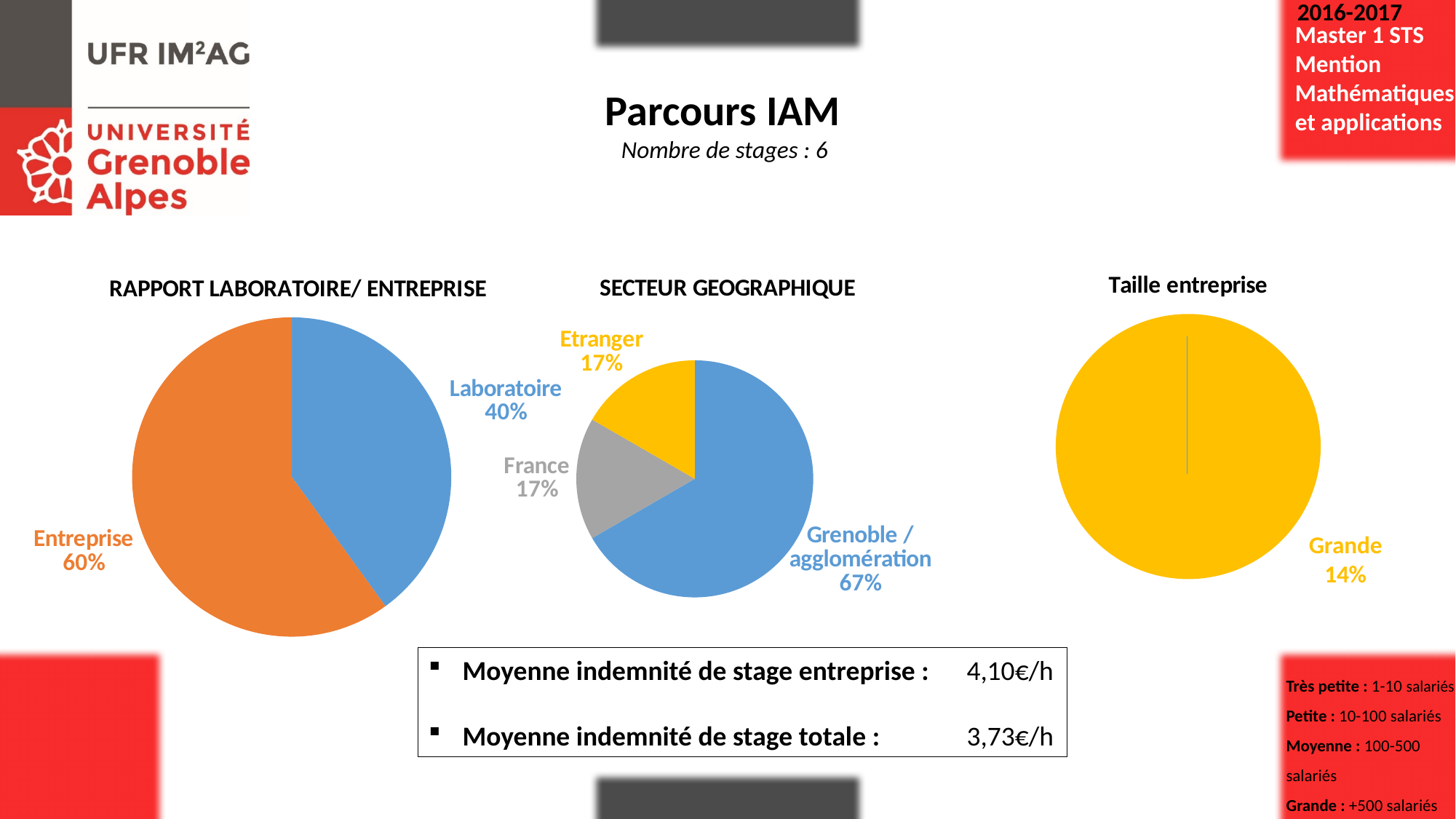
How many slices does the RAPPORT LABORATOIRE/ ENTREPRISE chart have? 2 In the RAPPORT LABORATOIRE/ ENTREPRISE chart, what share is Laboratoire? 40% In the SECTEUR GEOGRAPHIQUE chart, what share is Etranger? 17% What kind of chart is the SECTEUR GEOGRAPHIQUE chart? Pie chart In the RAPPORT LABORATOIRE/ ENTREPRISE chart, what is the difference in percentage points between Entreprise and Laboratoire? 20 percentage points In the SECTEUR GEOGRAPHIQUE chart, what is the difference in percentage points between Grenoble / agglomération and France? 50 percentage points In the RAPPORT LABORATOIRE/ ENTREPRISE chart, what share is Entreprise? 60% What colour is the Laboratoire slice in the RAPPORT LABORATOIRE/ ENTREPRISE chart? Blue How many categories are shown in the SECTEUR GEOGRAPHIQUE chart? 3 In the SECTEUR GEOGRAPHIQUE chart, which category has the largest share? Grenoble / agglomération In the RAPPORT LABORATOIRE/ ENTREPRISE chart, which slice is larger, Entreprise or Laboratoire? Entreprise